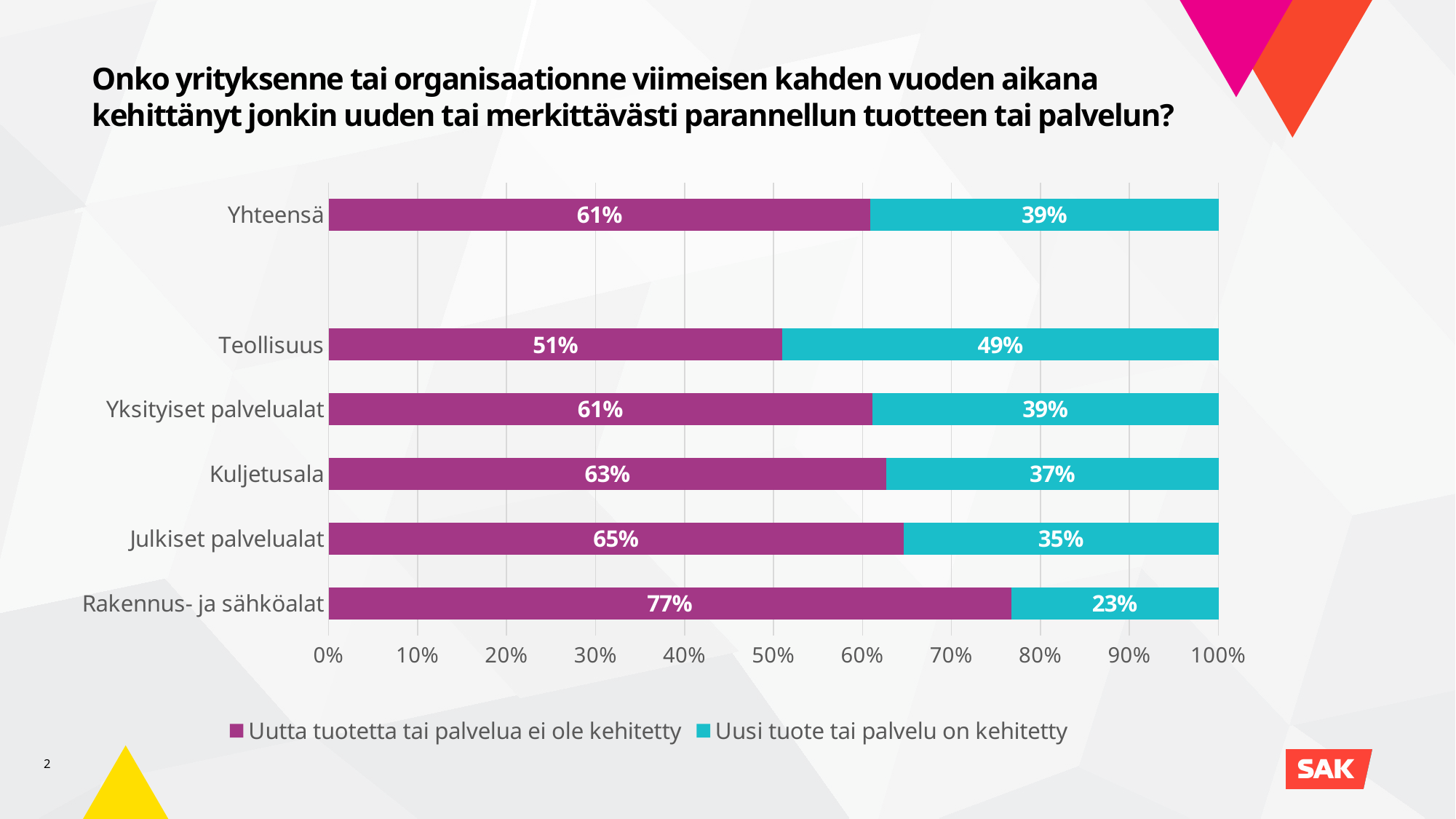
How many series does the legend list? 2 What is the value for Teollisuus in the series "Uusi tuote tai palvelu on kehitetty"? 49% Which category has the highest value in the series "Uusi tuote tai palvelu on kehitetty"? Teollisuus What is the value for Rakennus- ja sähköalat in the series "Uutta tuotetta tai palvelua ei ole kehitetty"? 77% What kind of chart is shown on the slide? Stacked bar chart How many categories are shown on the chart? 6 Which is larger: the "Uusi tuote tai palvelu on kehitetty" value for Kuljetusala or for Julkiset palvelualat? Kuljetusala Which category has the highest value in the series "Uutta tuotetta tai palvelua ei ole kehitetty"? Rakennus- ja sähköalat What is the value for Julkiset palvelualat in the series "Uusi tuote tai palvelu on kehitetty"? 35% What is the difference between the "Uutta tuotetta tai palvelua ei ole kehitetty" values for Rakennus- ja sähköalat and Teollisuus? 26% What is the total of the stacked bar for Yhteensä? 100% Which category has the lowest value in the series "Uusi tuote tai palvelu on kehitetty"? Rakennus- ja sähköalat